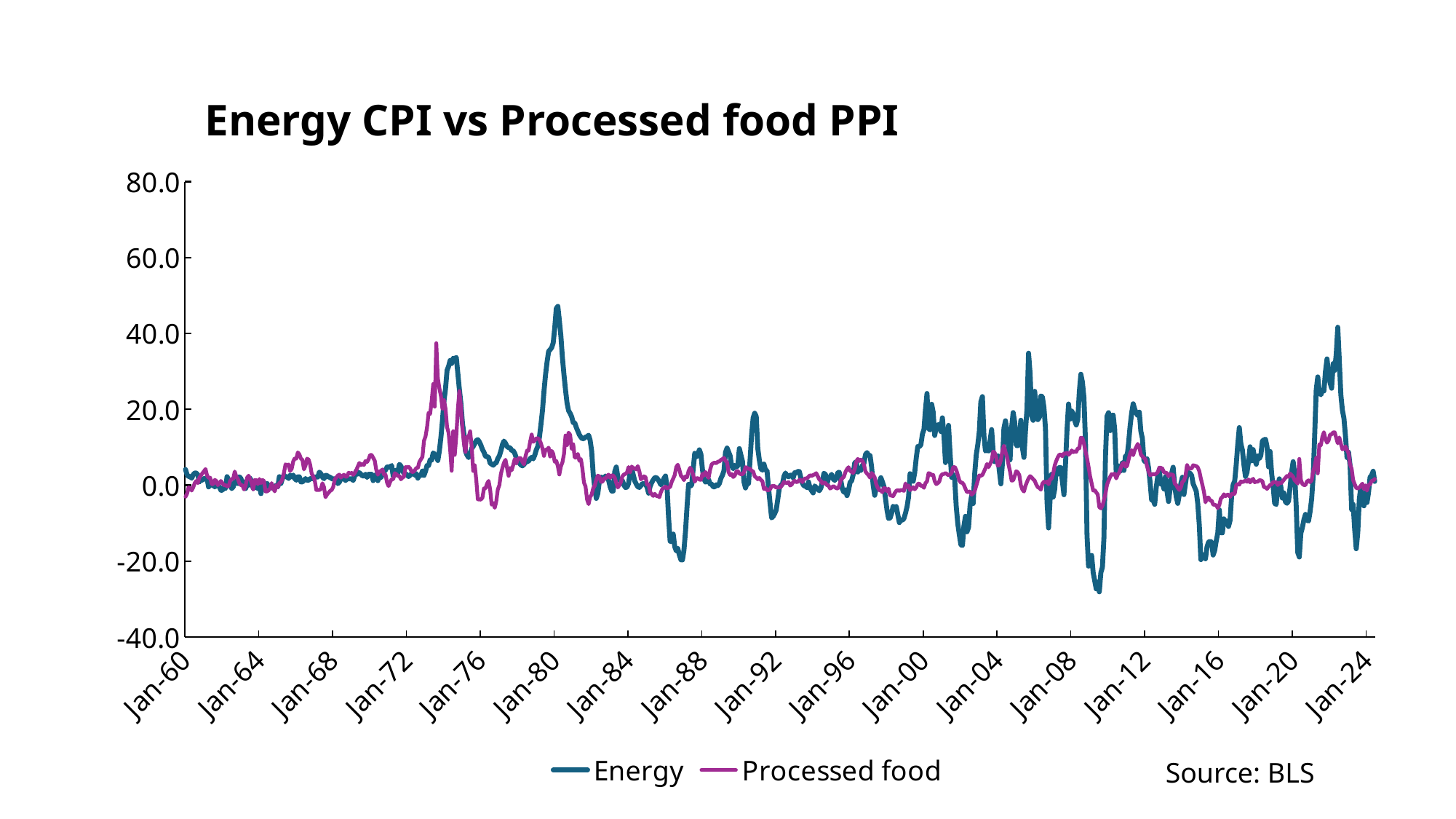
What is the highest value shown on the y axis? 80.0 Which series reaches the highest value anywhere on the chart? Energy What is the title of the chart? Energy CPI vs Processed food PPI How many year labels are shown on the x axis? 17 Is the value of the Processed food series at Jan-80 greater or less than 20? less What kind of chart is shown on the slide? line chart Is the peak value of the Energy series around Jan-80 greater or less than 40? greater How many series does the legend list? 2 What are the two series named in the legend? Energy and Processed food Which series reaches the lowest value anywhere on the chart? Energy Is the lowest value of the Energy series around 2009 greater or less than -20? less